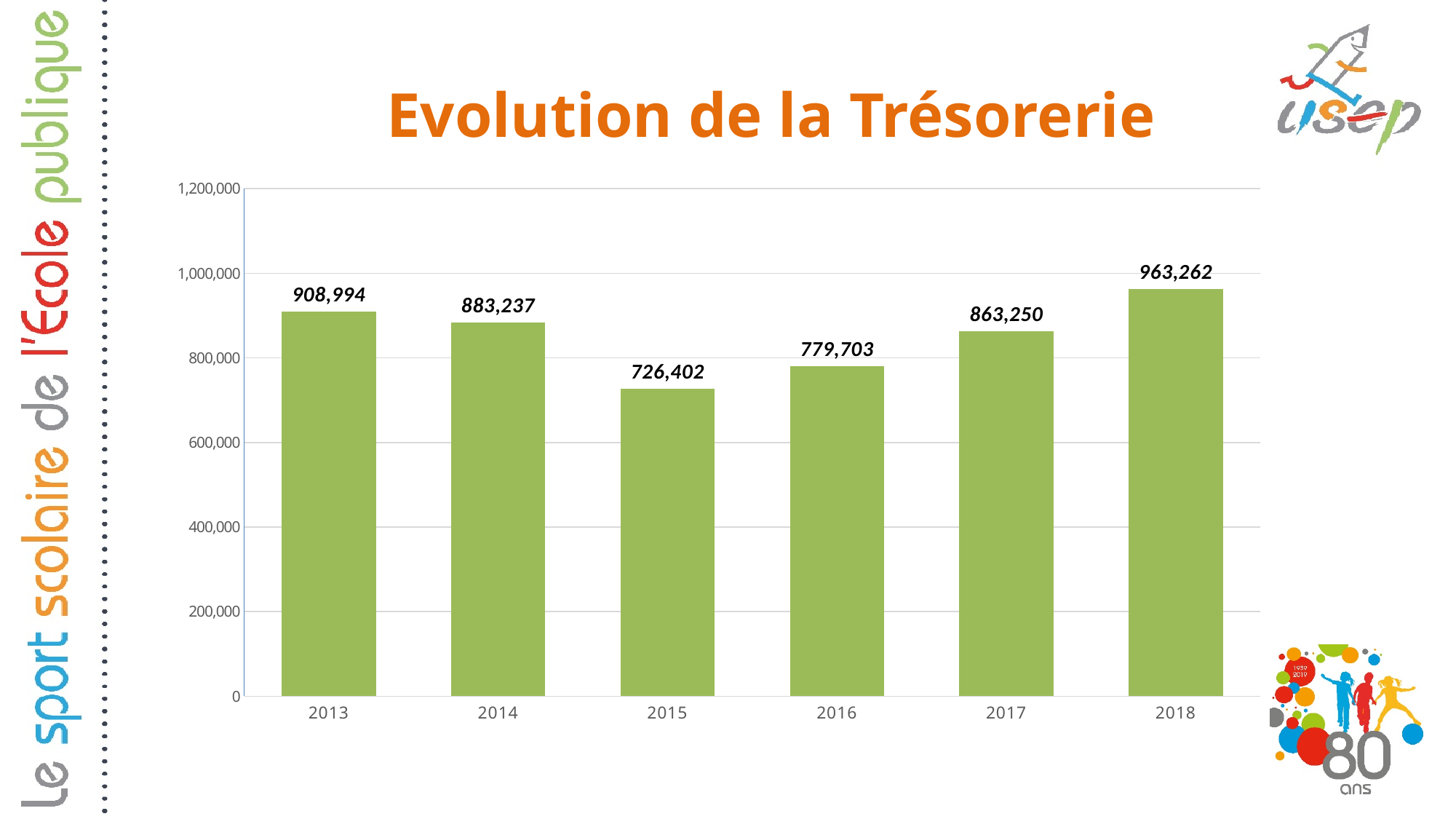
What is the difference between the values for 2013 and 2015? 182,592 Which year has the lowest value? 2015 What is the value for 2015? 726,402 What is the title of the chart? Evolution de la Trésorerie What is the value for 2018? 963,262 What is the value for 2013? 908,994 What is the difference between the values for 2018 and 2017? 100,012 Is the value for 2016 greater or less than 800,000? less Which year has the highest value? 2018 What kind of chart is shown on the slide? bar chart Which is larger, the value for 2014 or the value for 2016? 2014 How many years are shown on the x axis? 6